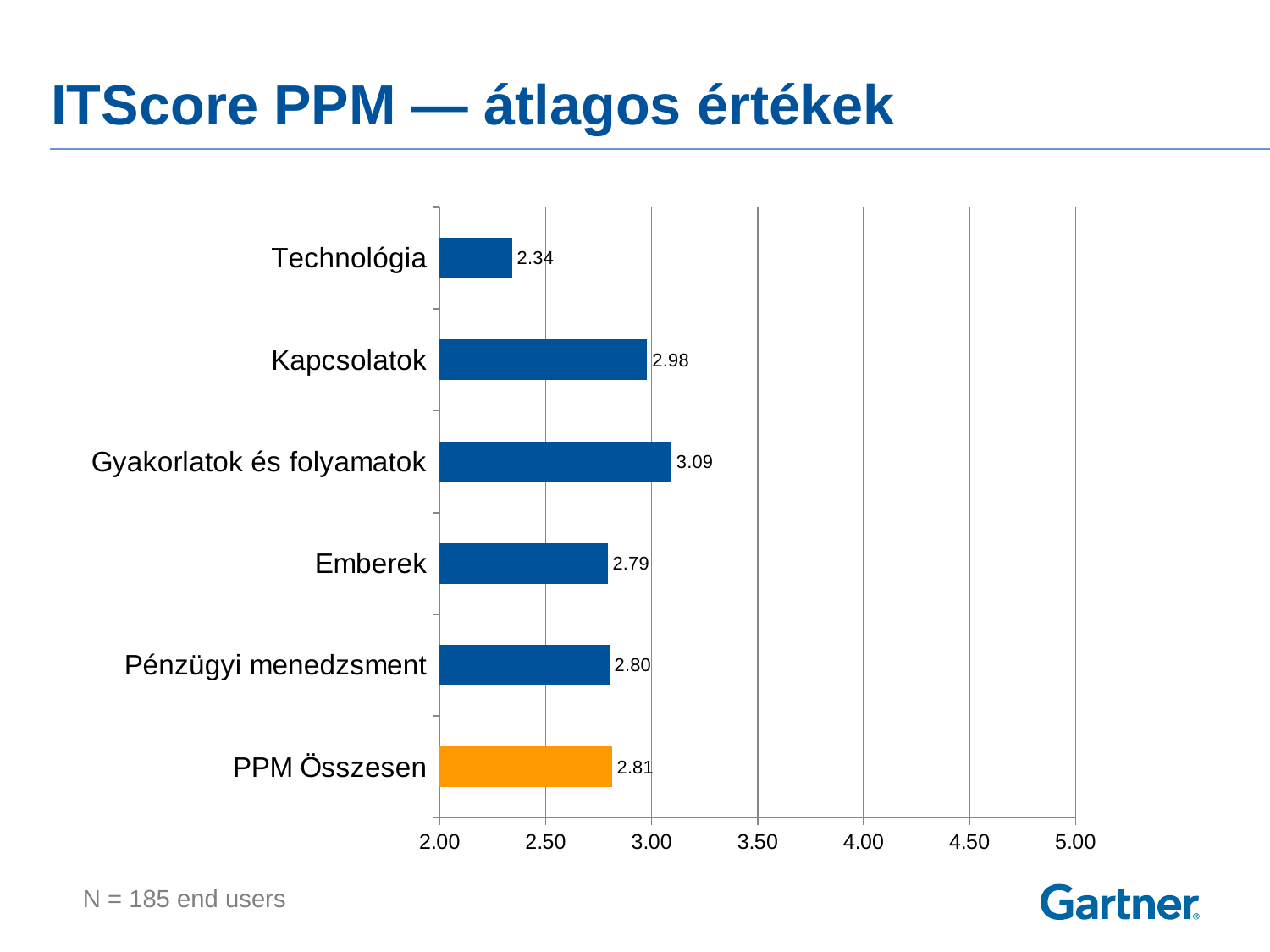
Which category has the highest value? Gyakorlatok és folyamatok What is the value for PPM Összesen? 2.81 What is the value for Gyakorlatok és folyamatok? 3.09 What is the value for Kapcsolatok? 2.98 How many categories are shown in the chart? 6 Which is larger, the value for Kapcsolatok or the value for Pénzügyi menedzsment? Kapcsolatok Which category has the lowest value? Technológia Which category's bar is coloured orange instead of blue? PPM Összesen What is the difference between the values for Gyakorlatok és folyamatok and Technológia? 0.75 What is the value for Technológia? 2.34 What kind of chart is shown on the slide? Bar chart What is the difference between the values for Kapcsolatok and Emberek? 0.19